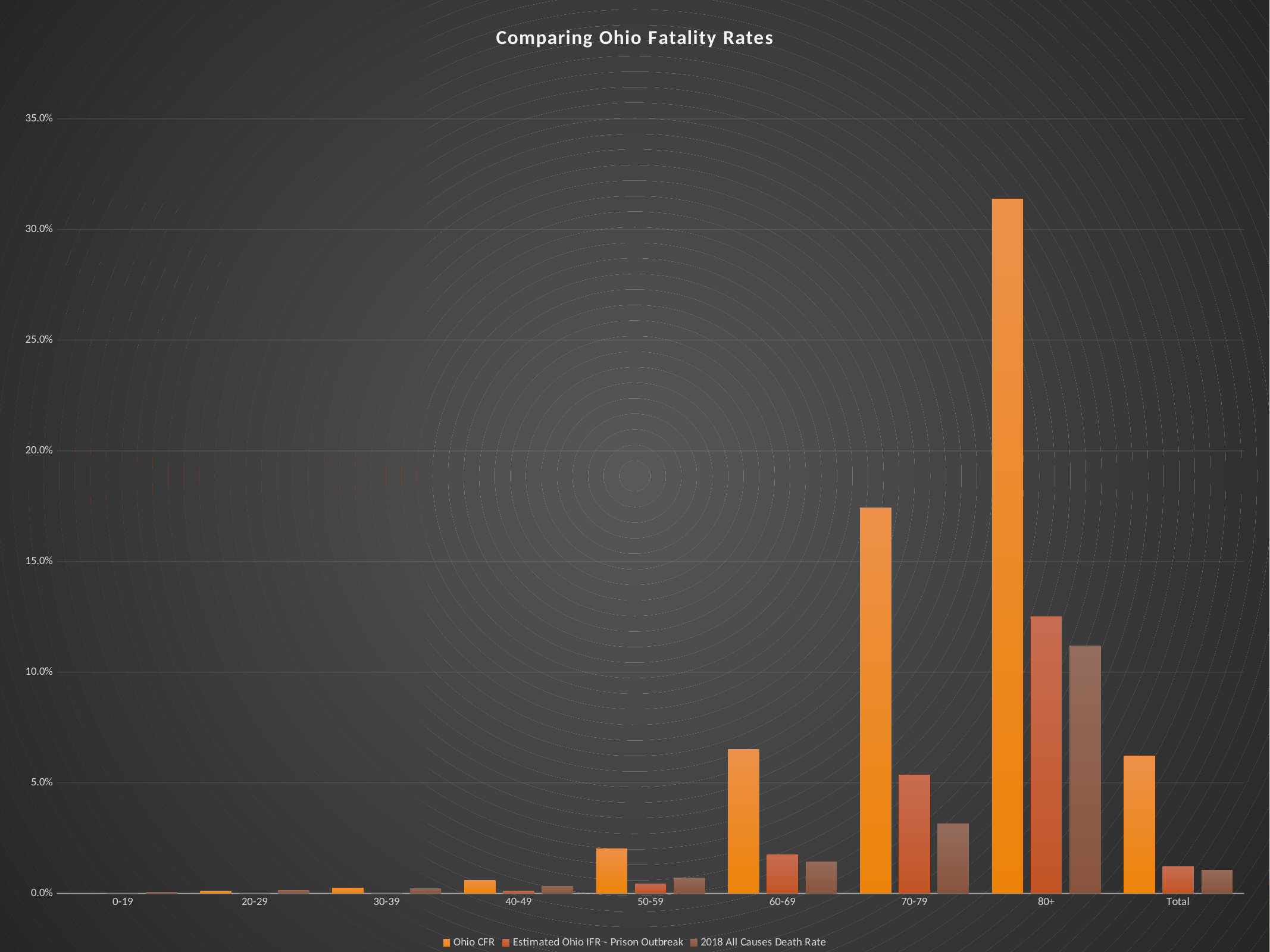
How many series does the legend list? 3 Is the Estimated Ohio IFR - Prison Outbreak value for 80+ greater or less than 10.0%? greater Is the 2018 All Causes Death Rate value for 70-79 greater or less than 5.0%? less Which category has the highest Ohio CFR value? 80+ Is the Ohio CFR value for 80+ greater or less than 30.0%? greater What kind of chart is shown on the slide? bar chart How many categories are shown on the x axis? 9 Do the Ohio CFR values rise or fall across the age groups from 0-19 to 80+? rise What is the title of the chart? Comparing Ohio Fatality Rates Which is larger, the Ohio CFR value for 80+ or the Ohio CFR value for 70-79? 80+ Which series is listed first in the legend? Ohio CFR